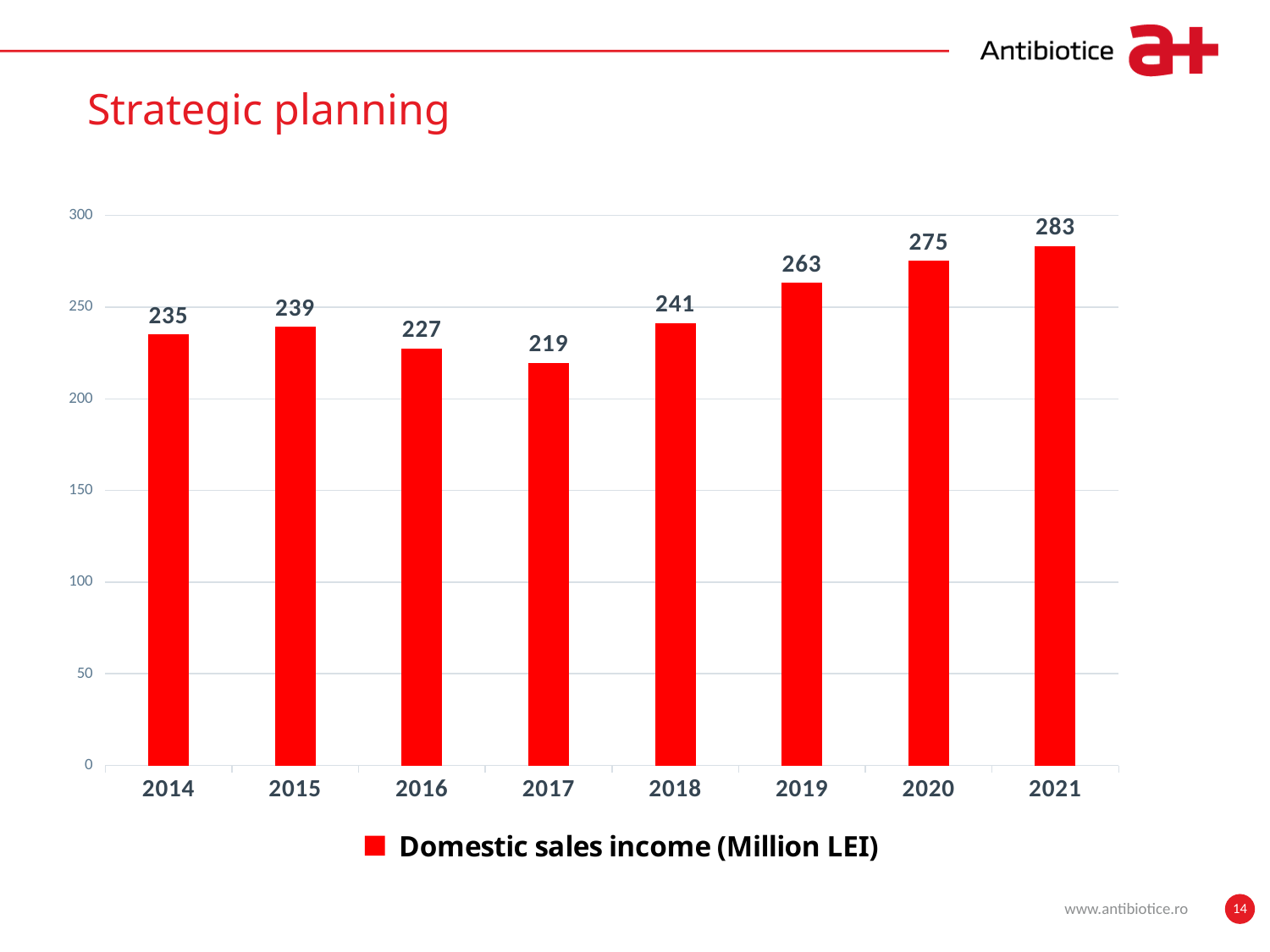
What kind of chart is shown on the slide? bar chart How many years are shown on the chart? 8 Which year has the lowest domestic sales income? 2017 Which year has the highest domestic sales income? 2021 Which year has a larger domestic sales income, 2015 or 2018? 2018 What is the difference in domestic sales income between 2016 and 2017? 8 What is the legend entry for the series shown in the chart? Domestic sales income (Million LEI) What is the domestic sales income for 2014? 235 What is the difference in domestic sales income between 2021 and 2014? 48 Is the domestic sales income for 2019 greater or less than 250? greater What is the domestic sales income for 2021? 283 What is the domestic sales income for 2017? 219